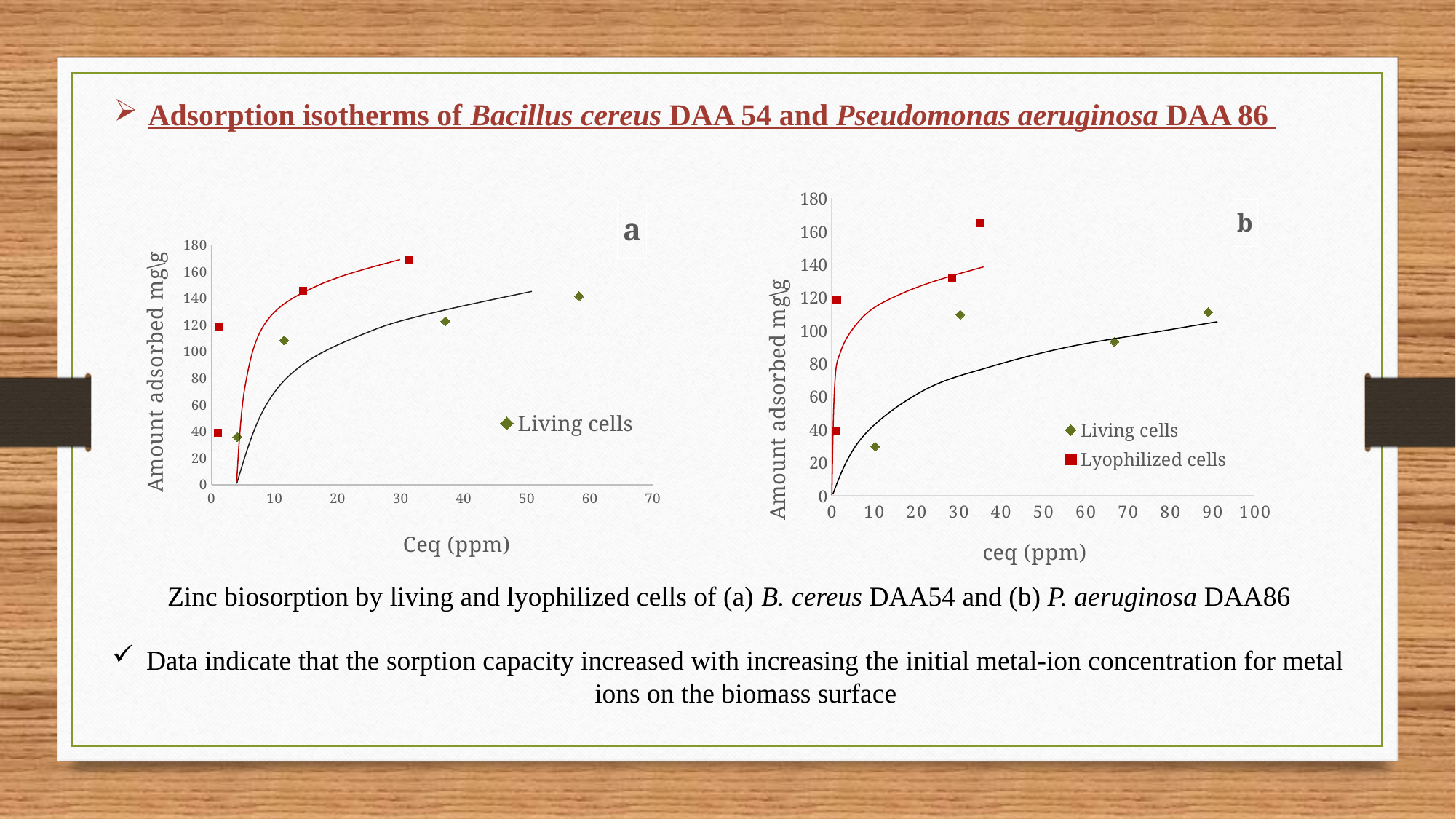
In chart (b), how many Lyophilized cells data points are plotted? 4 What is the maximum value shown on the x axis of chart (b)? 100 In chart (a), which series reaches the higher amount adsorbed, Living cells or Lyophilized cells? Lyophilized cells In chart (a), is the Living cells point at about 58 ppm greater or less than 120 mg\g? greater In chart (a), how many Living cells data points are plotted? 4 In chart (a), do the Living cells values rise or fall as Ceq increases? rise In chart (b), what are the two series named in the legend? Living cells and Lyophilized cells How many series does the legend of chart (b) list? 2 In chart (a), is the highest Lyophilized cells point greater or less than 160 mg\g? greater What kind of chart is chart (a) on the left? scatter chart In chart (b), is the Living cells point at about 10 ppm greater or less than 40 mg\g? less What is the y-axis title of chart (a)? Amount adsorbed mg\g